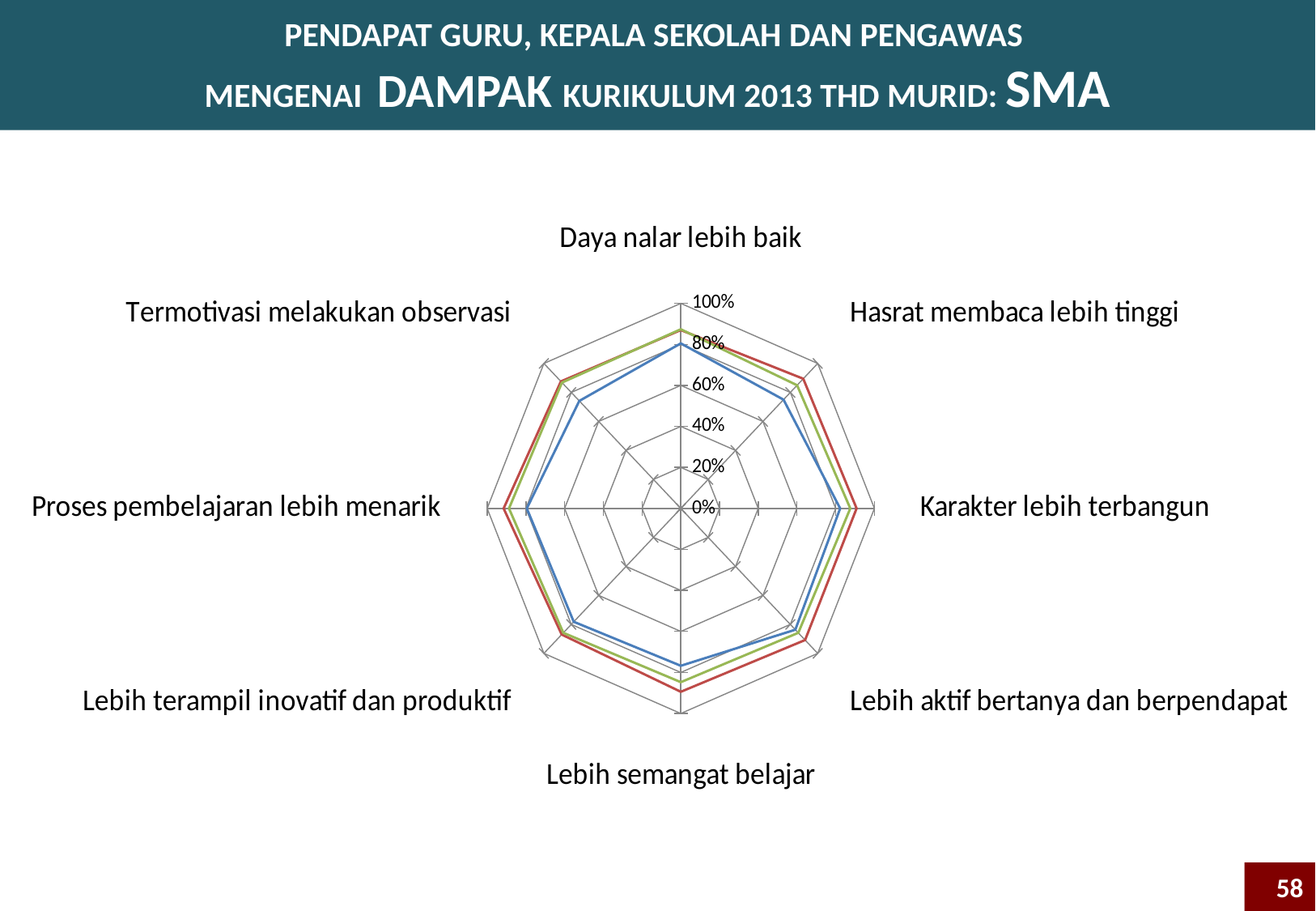
How many categories (axes) does the radar chart have? 8 Is the value of the red line for 'Daya nalar lebih baik' greater or less than 80%? greater Is the value of the blue line for 'Termotivasi melakukan observasi' greater or less than 80%? less What is the maximum value shown on the radar chart's axis scale? 100% Is the value of the red line for 'Proses pembelajaran lebih menarik' greater or less than 80%? greater What kind of chart is shown on the slide? radar chart How many data series (lines) are plotted on the radar chart? 3 For 'Lebih semangat belajar', which line has the larger value, the red line or the blue line? red line